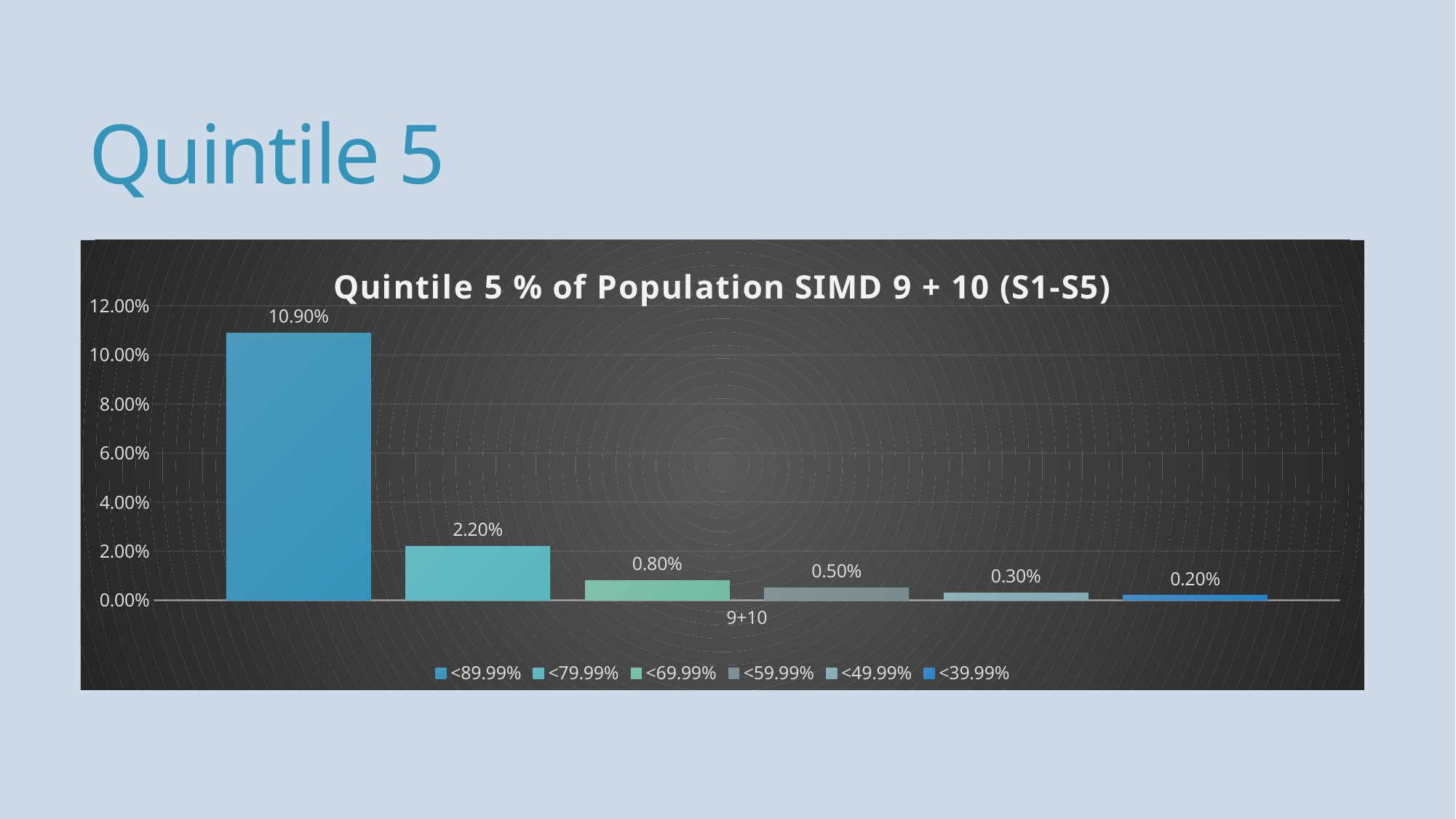
Is the value for <89.99% greater or less than 10.00%? greater Which series has the highest value? <89.99% Which series has the lowest value? <39.99% What is the title of the chart? Quintile 5 % of Population SIMD 9 + 10 (S1-S5) Which is larger, the value for <59.99% or the value for <49.99%? <59.99% What is the value for the <79.99% series? 2.20% What is the difference between the <89.99% and <79.99% values? 8.70% How many series does the legend list? 6 What is the value for the <89.99% series? 10.90% What is the value for the <69.99% series? 0.80% What is the value for the <39.99% series? 0.20% What kind of chart is shown? bar chart